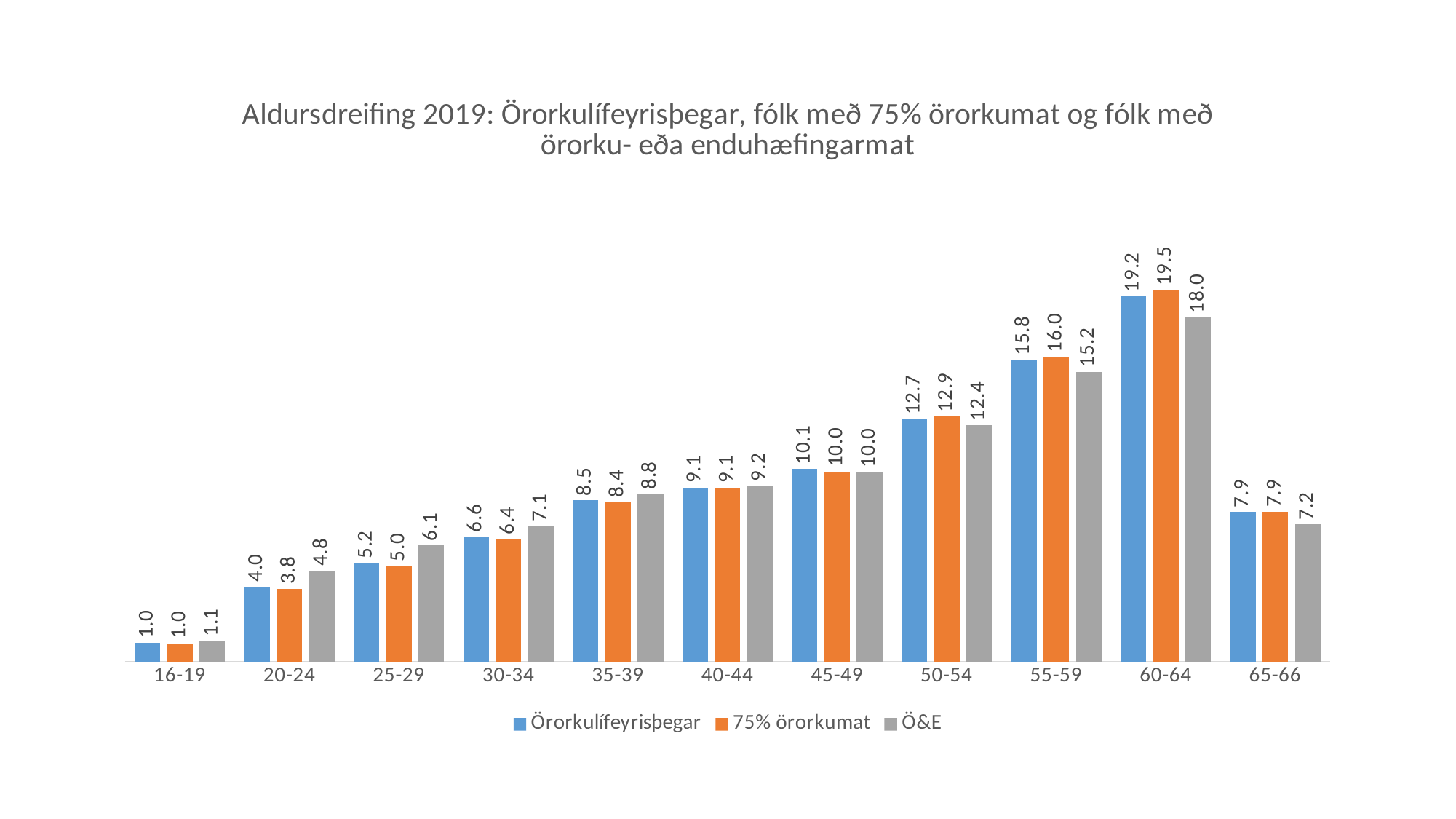
Do the Örorkulífeyrisþegar values rise or fall from the 16-19 age group to the 60-64 age group? Rise What is the value for 75% örorkumat in the 50-54 age group? 12.9 Which colour represents the Ö&E series in the legend? Grey What kind of chart is shown on the slide? Bar chart How many age groups are shown on the x axis? 11 What is the value for Ö&E in the 25-29 age group? 6.1 Which age group has the highest value for 75% örorkumat? 60-64 What is the value for Örorkulífeyrisþegar in the 60-64 age group? 19.2 How many series does the legend list? 3 Which is larger in the 30-34 age group: the Örorkulífeyrisþegar value or the Ö&E value? Ö&E What is the difference between the Örorkulífeyrisþegar and Ö&E values in the 60-64 age group? 1.2 Which age group has the lowest value for Ö&E? 16-19